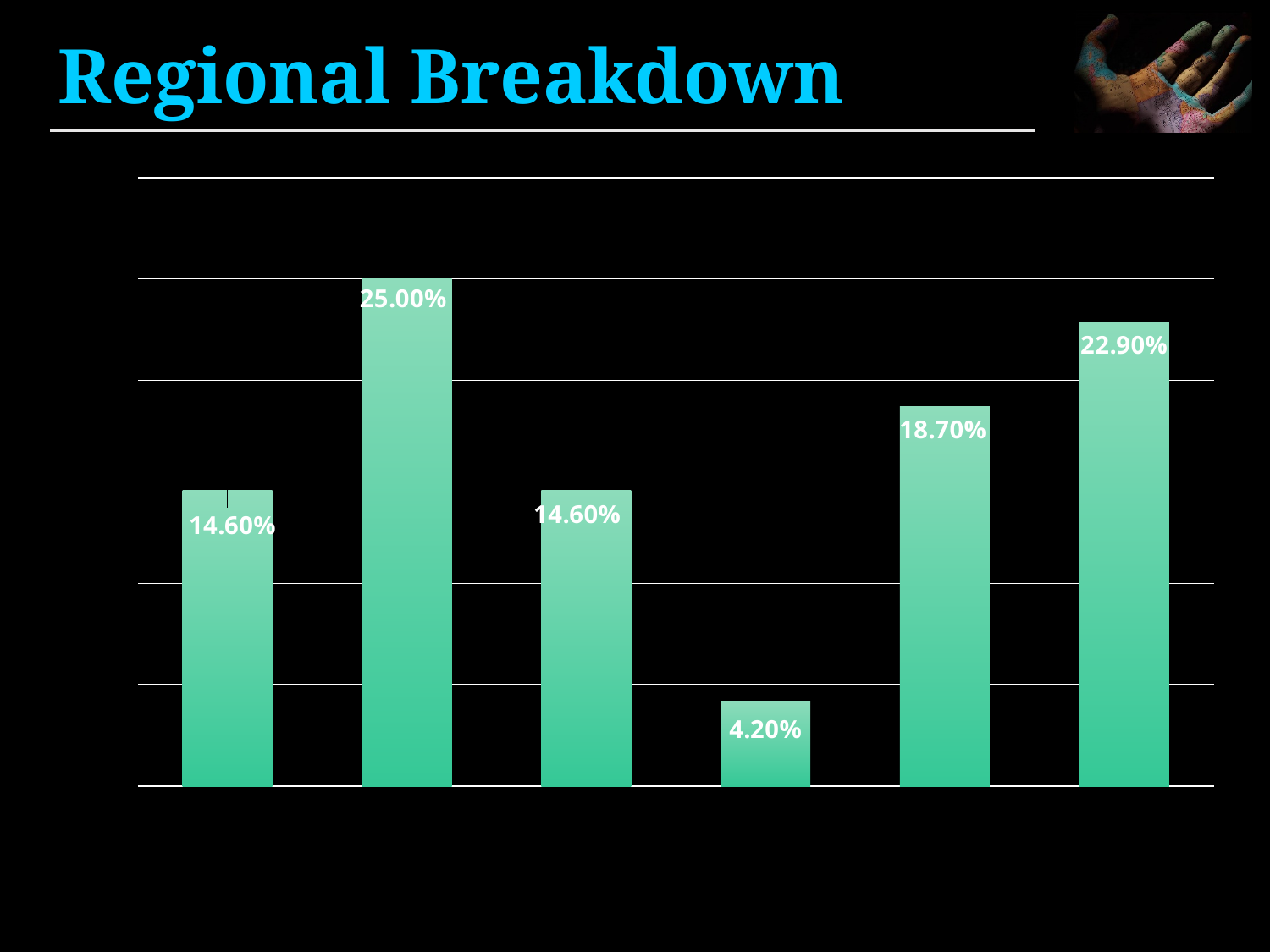
What is the lowest value shown in the chart? 4.20% What is the highest value shown in the chart? 25.00% What is the value shown on the second bar from the left? 25.00% What type of chart is shown on the slide? bar chart How many bars are plotted in the chart? 6 What is the value shown on the fifth bar from the left? 18.70% What is the value shown on the first bar from the left? 14.60% Which is larger, the value of the fifth bar or the value of the third bar? the fifth bar (18.70%) What is the value shown on the fourth bar from the left? 4.20% What is the title of the slide containing the chart? Regional Breakdown What is the value shown on the rightmost bar? 22.90% What is the difference between the second bar (25.00%) and the rightmost bar (22.90%)? 2.10%